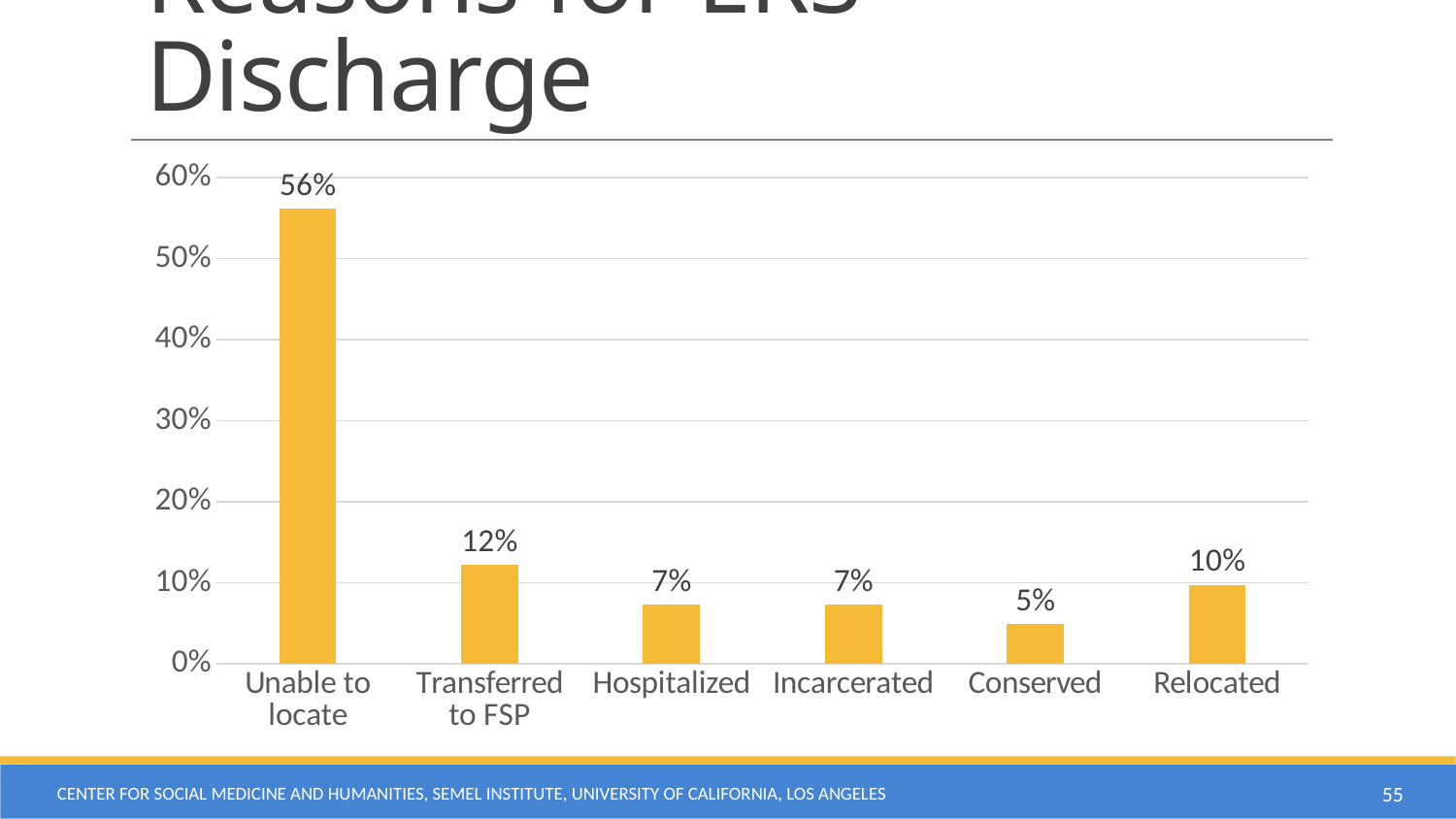
How many categories are shown on the x axis? 6 What is the value for Relocated? 10% What is the value for Unable to locate? 56% What kind of chart is shown on the slide? bar chart What is the value for Transferred to FSP? 12% What is the difference between the values for Unable to locate and Transferred to FSP? 44% What is the value for Conserved? 5% Which category has the highest value? Unable to locate Which is larger, the value for Transferred to FSP or the value for Relocated? Transferred to FSP What is the difference between the values for Relocated and Conserved? 5% Is the value for Hospitalized greater or less than 10%? less Which category has the lowest value? Conserved